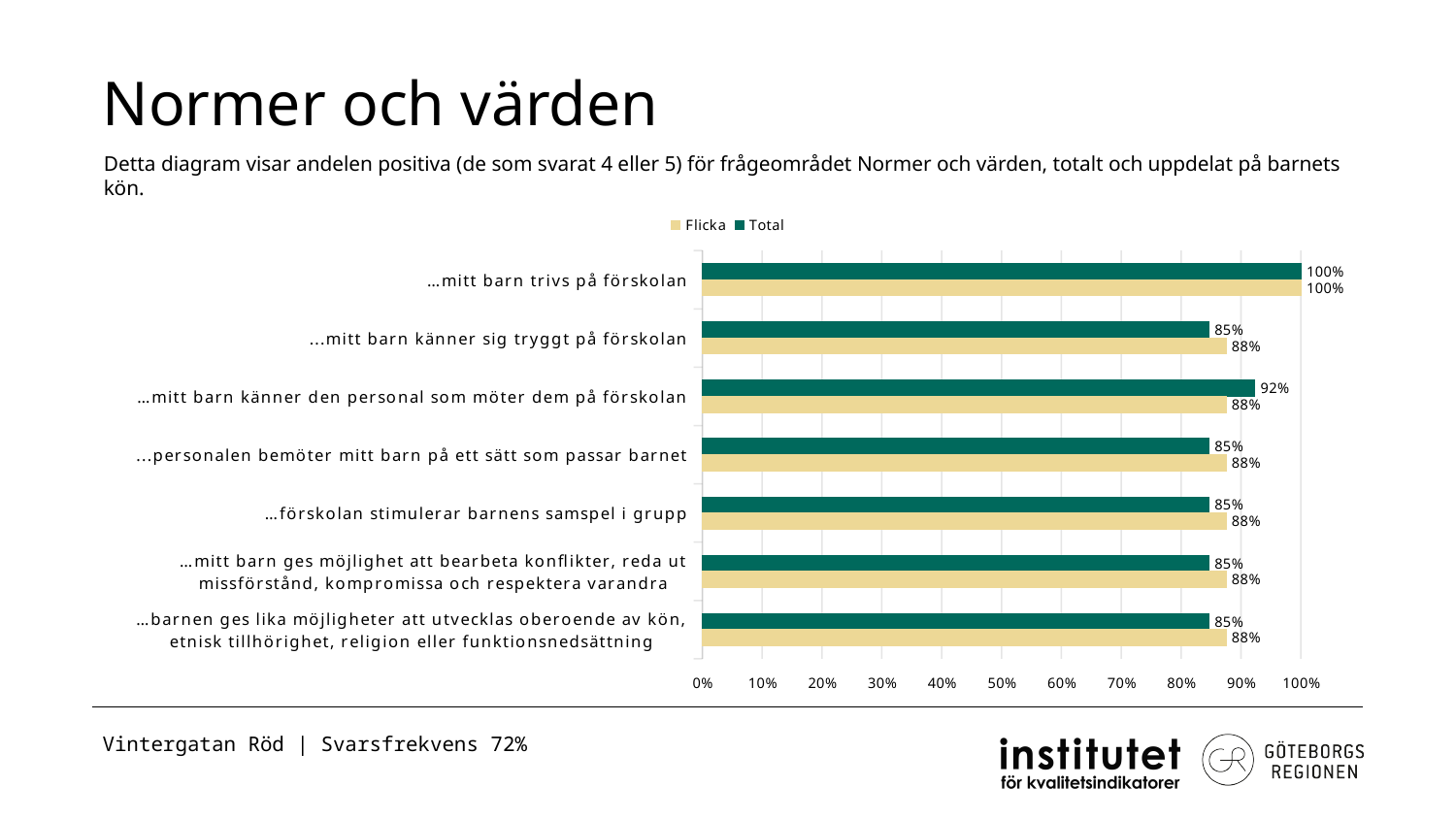
Which colour represents the Total series in the chart? green What is the difference between the Total and Flicka values for "…mitt barn känner den personal som möter dem på förskolan"? 4% Which category has the highest Total value? …mitt barn trivs på förskolan What is the difference between the Flicka and Total values for "…mitt barn ges möjlighet att bearbeta konflikter, reda ut missförstånd, kompromissa och respektera varandra"? 3% What is the Flicka value for "...personalen bemöter mitt barn på ett sätt som passar barnet"? 88% What is the Flicka value for "…mitt barn trivs på förskolan"? 100% What type of chart is shown on the slide? bar chart What is the Total value for "…mitt barn känner den personal som möter dem på förskolan"? 92% How many series does the legend list? 2 What is the Total value for "…förskolan stimulerar barnens samspel i grupp"? 85% For "...mitt barn känner sig tryggt på förskolan", which is larger, the Flicka value or the Total value? Flicka How many categories (statements) are plotted in the chart? 7